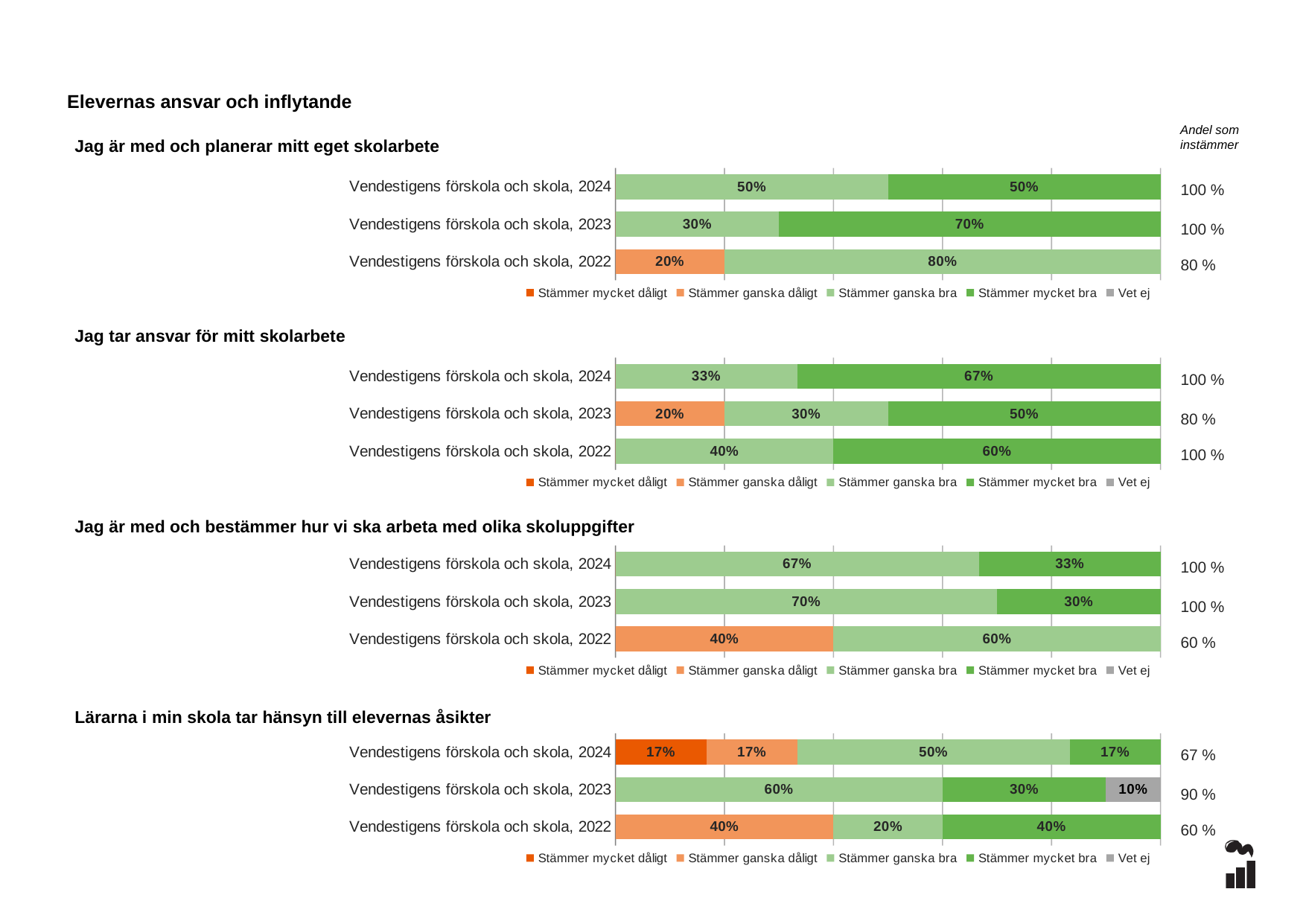
In the chart 'Jag är med och planerar mitt eget skolarbete', what is the value for 'Stämmer mycket bra' for Vendestigens förskola och skola, 2023? 70% In the chart 'Lärarna i min skola tar hänsyn till elevernas åsikter', what is the value for 'Stämmer mycket dåligt' for Vendestigens förskola och skola, 2024? 17% In the chart 'Jag är med och planerar mitt eget skolarbete', what is the 'Andel som instämmer' for Vendestigens förskola och skola, 2022? 80 % How many bars are shown in the chart 'Jag är med och planerar mitt eget skolarbete'? 3 In the chart 'Lärarna i min skola tar hänsyn till elevernas åsikter', which year has the highest 'Andel som instämmer'? Vendestigens förskola och skola, 2023 In the chart 'Jag tar ansvar för mitt skolarbete', what is the value for 'Stämmer ganska dåligt' for Vendestigens förskola och skola, 2023? 20% In the chart 'Lärarna i min skola tar hänsyn till elevernas åsikter', what is the value for 'Vet ej' for Vendestigens förskola och skola, 2023? 10% In the chart 'Jag tar ansvar för mitt skolarbete', which year has the lowest 'Andel som instämmer'? Vendestigens förskola och skola, 2023 In the chart 'Jag är med och bestämmer hur vi ska arbeta med olika skoluppgifter', what is the difference between the 'Stämmer ganska bra' values for 2023 and 2024? 3% How many series does the legend list for the chart 'Jag tar ansvar för mitt skolarbete'? 5 In the chart 'Jag är med och bestämmer hur vi ska arbeta med olika skoluppgifter', which is larger: 'Stämmer ganska dåligt' for 2022 or 'Stämmer mycket bra' for 2024? Stämmer ganska dåligt for 2022 What kind of chart is 'Lärarna i min skola tar hänsyn till elevernas åsikter'? Stacked bar chart